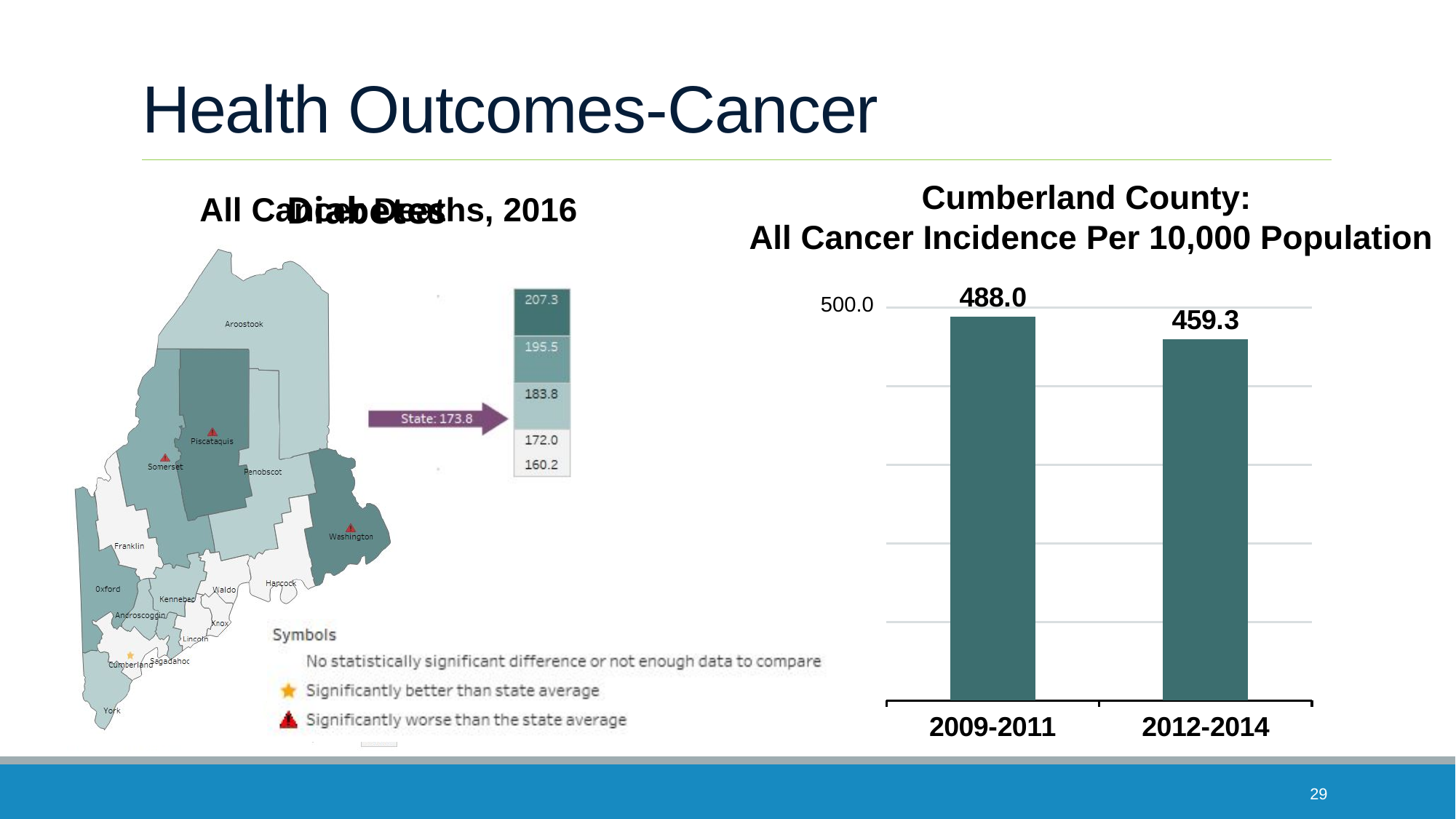
In the bar chart on the right, what is the all cancer incidence per 10,000 population for Cumberland County in 2009-2011? 488.0 In the bar chart on the right, is the value for 2012-2014 greater or less than 500.0? less In the bar chart on the right, what is the all cancer incidence per 10,000 population for Cumberland County in 2012-2014? 459.3 In the bar chart on the right, does the all cancer incidence rise or fall from 2009-2011 to 2012-2014? fall On the map on the left, what is the state value shown by the arrow next to the colour scale? State: 173.8 How many periods are shown in the bar chart on the right? 2 What is the title of the bar chart on the right of the slide? Cumberland County: All Cancer Incidence Per 10,000 Population In the bar chart on the right, which period has the highest all cancer incidence? 2009-2011 In the bar chart on the right, which is larger: the value for 2009-2011 or the value for 2012-2014? 2009-2011 What kind of chart is the Cumberland County all cancer incidence chart on the right? bar chart In the bar chart on the right, what is the difference between the 2009-2011 and 2012-2014 values? 28.7 In the bar chart on the right, which period has the lowest all cancer incidence? 2012-2014